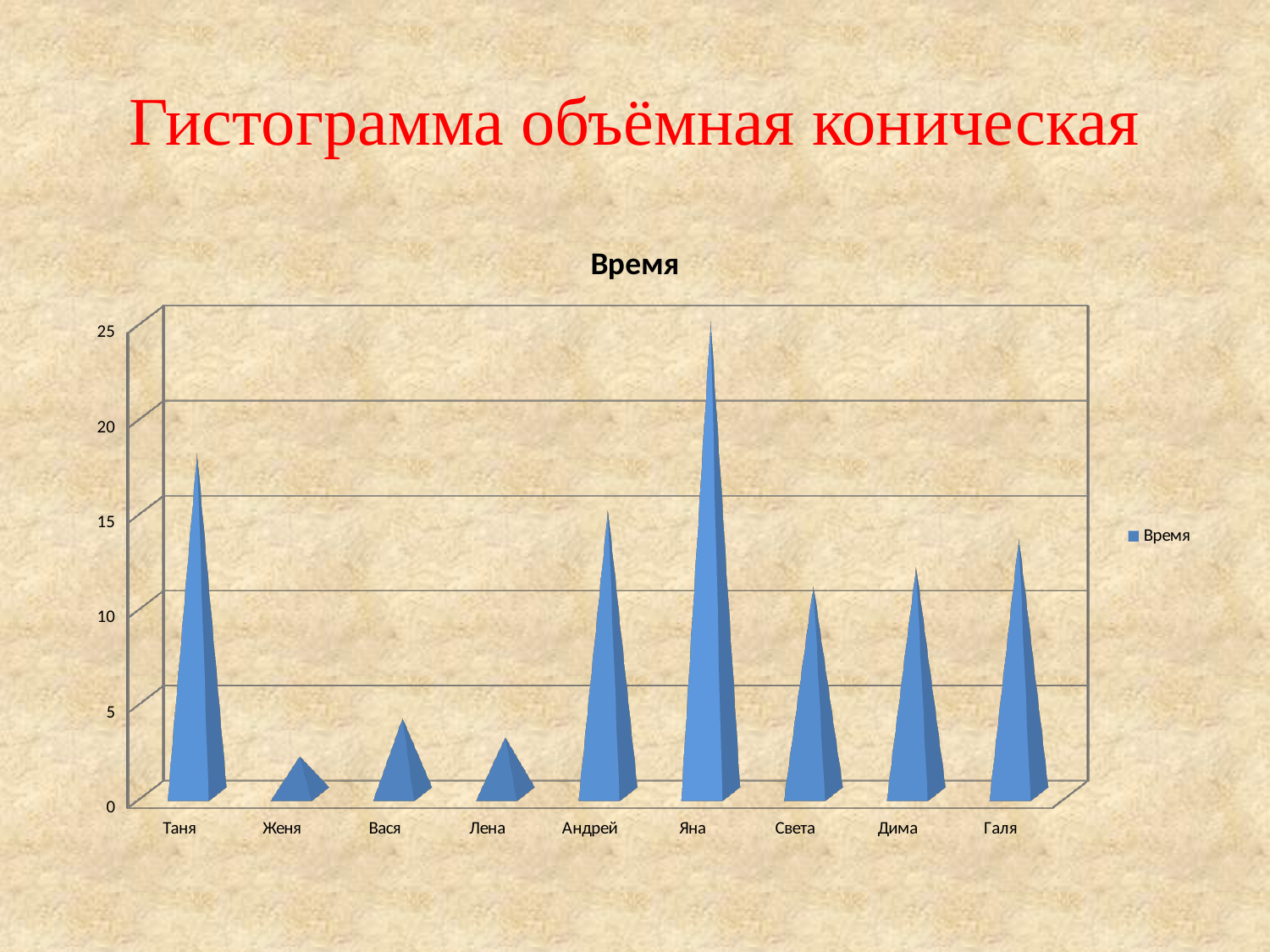
What is the title of the chart? Время What kind of chart is shown on the slide? bar chart Is the value for Женя greater or less than 5? less Which category has the highest value in the chart? Яна Is the value for Лена greater or less than 5? less Which has the larger value, Таня or Андрей? Таня Which has the larger value, Галя or Света? Галя How many categories are shown on the x axis of the chart? 9 How many series does the legend list? 1 Is the value for Таня greater or less than 15? greater